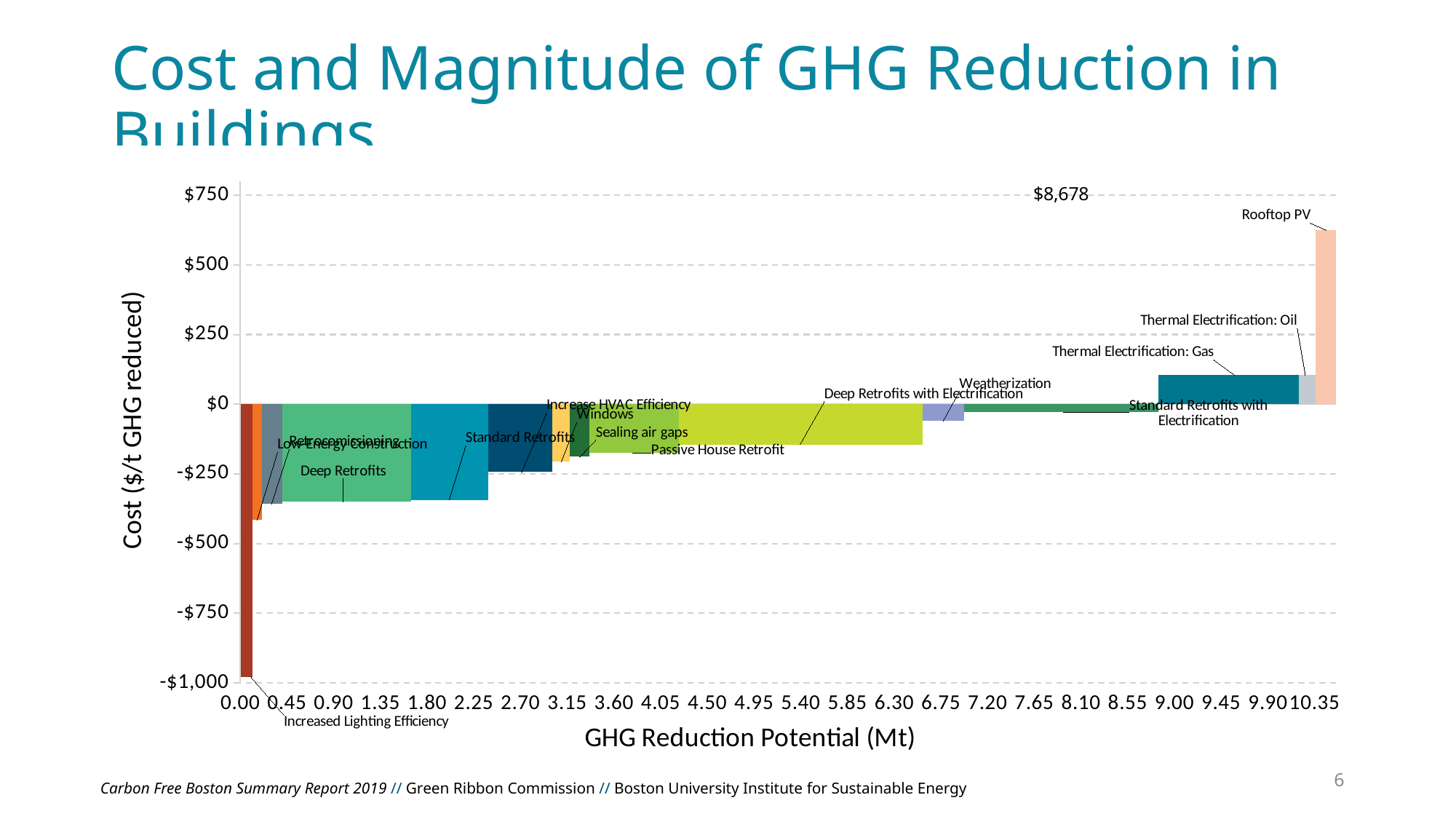
Is the cost for Passive House Retrofit greater or less than -$250? greater What kind of chart is shown on the slide? bar chart Is the cost for Deep Retrofits greater or less than -$250? less Which measure has the highest cost per tonne of GHG reduced? Rooftop PV What cost value is printed as a data label for Rooftop PV? $8,678 Do the costs of the measures rise or fall moving left to right along the x axis? rise Is the cost for Thermal Electrification: Gas greater or less than $250? less What is the title of the x axis? GHG Reduction Potential (Mt) What is the title of the y axis? Cost ($/t GHG reduced) Which measure has the lowest (most negative) cost per tonne of GHG reduced? Increased Lighting Efficiency Which has the lower cost per tonne: Deep Retrofits or Passive House Retrofit? Deep Retrofits